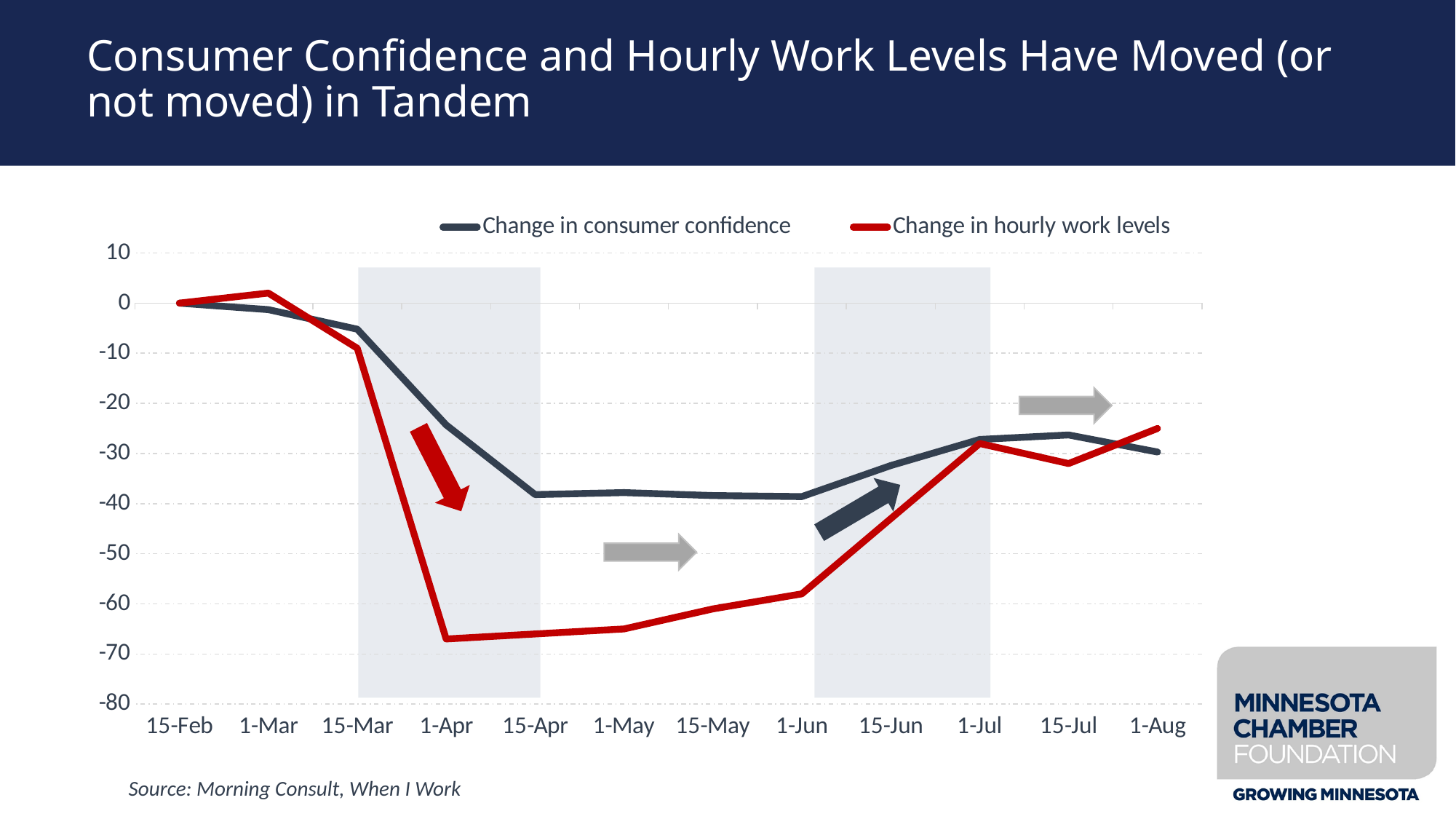
Is the value for 'Change in hourly work levels' at 1-Apr greater or less than -60? less At 1-May, which series has the higher value, 'Change in consumer confidence' or 'Change in hourly work levels'? Change in consumer confidence What kind of chart is shown on the slide? line chart Is the value for 'Change in hourly work levels' at 1-Jun greater or less than -50? less How many series does the legend list? 2 What source is cited below the chart? Morning Consult, When I Work Do the values for 'Change in hourly work levels' rise or fall between 1-Apr and 1-Jul? rise How many dates are shown along the x axis? 12 What is the value of 'Change in consumer confidence' at 15-Feb? 0 At which date does 'Change in hourly work levels' reach its lowest point? 1-Apr What colour is the line for 'Change in hourly work levels'? red Is the value for 'Change in consumer confidence' at 15-Apr greater or less than -30? less